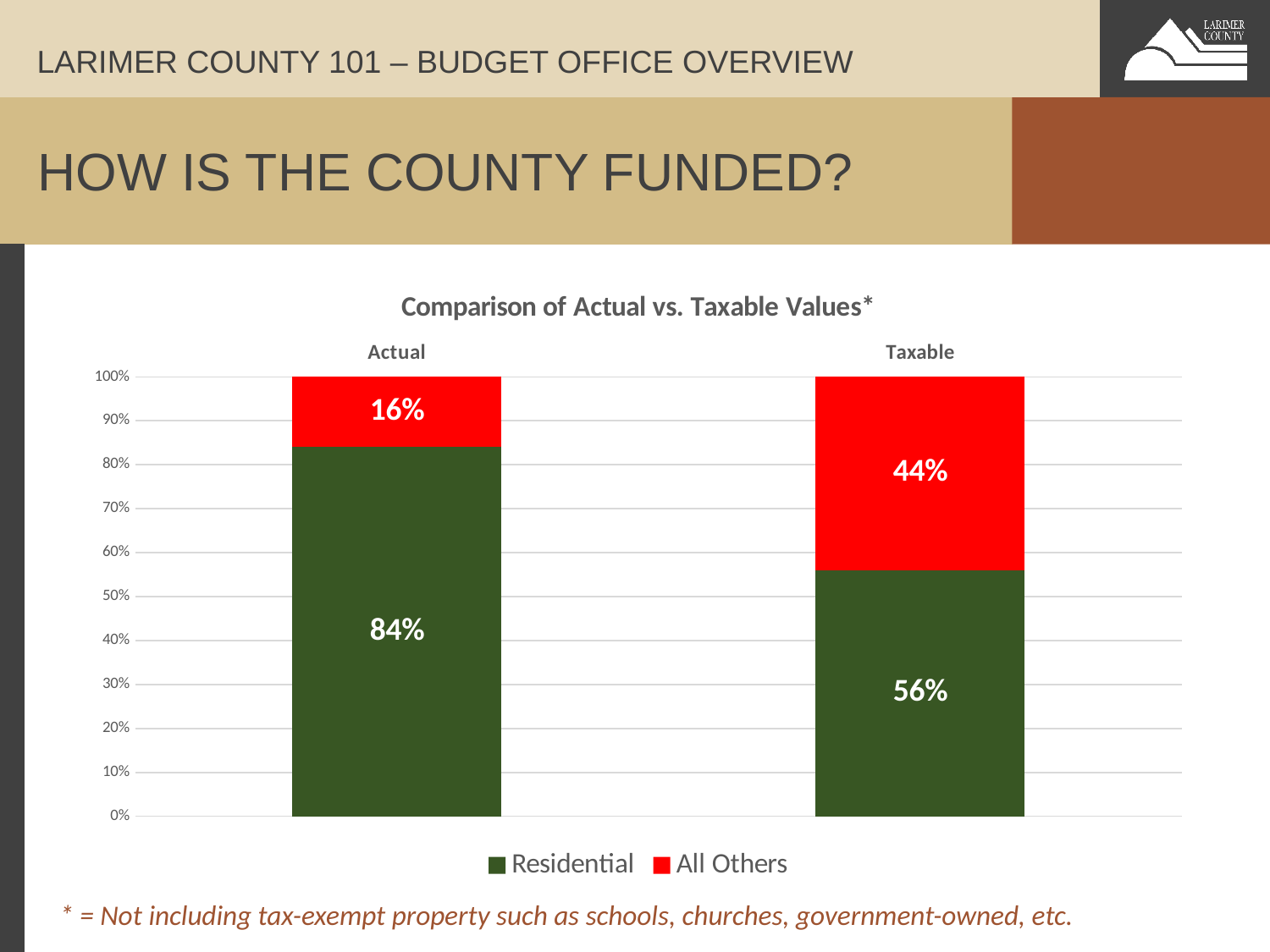
What is the difference between the Residential share for Actual and for Taxable? 28% What is the All Others share of Actual values? 16% Which category has the higher Residential share, Actual or Taxable? Actual What is the difference between the All Others share for Taxable and for Actual? 28% What is the Residential share of Taxable values? 56% What is the Residential share of Actual values? 84% How many categories are shown on the x axis? 2 What is the All Others share of Taxable values? 44% How many series does the legend list? 2 Which category has the lower All Others share? Actual What is the title of the chart? Comparison of Actual vs. Taxable Values* What is the total of the stacked bar for Taxable? 100%